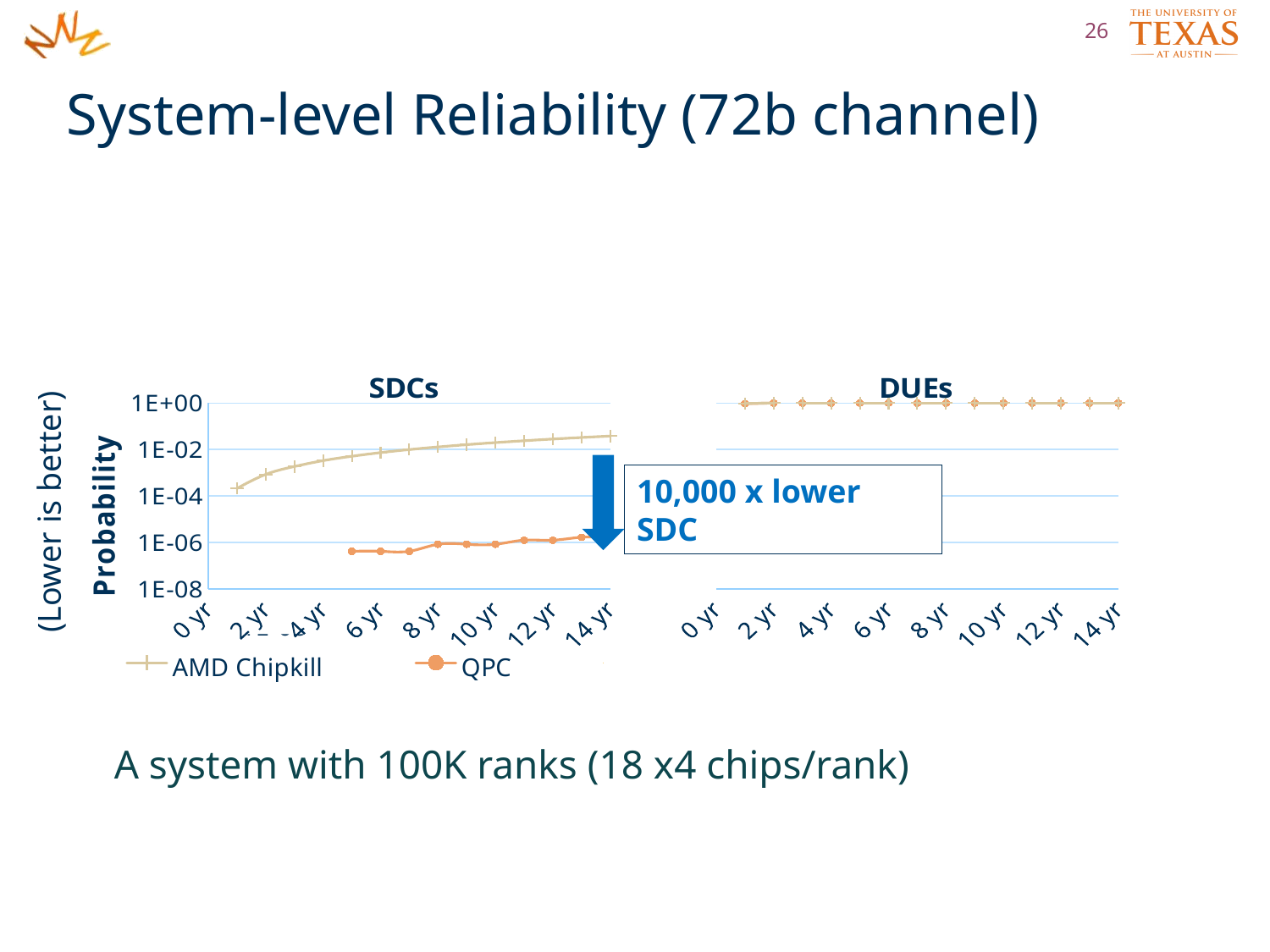
In the SDCs chart, which series has the higher probability at 14 yr, AMD Chipkill or QPC? AMD Chipkill In the SDCs chart, is the QPC value at 14 yr greater or less than 1E-04? less What are the two series named in the legend? AMD Chipkill and QPC In the DUEs chart, is the value at 10 yr greater or less than 1E-02? greater In the SDCs chart, which series has the lowest probability at 6 yr? QPC In the SDCs chart, is the AMD Chipkill value at 2 yr greater or less than 1E-04? greater What kind of chart is the SDCs chart? line chart In the SDCs chart, does the AMD Chipkill probability rise or fall as the years increase? rise How many series does the legend list? 2 How many year labels are shown on the x axis of the SDCs chart? 8 What is the title of the chart on the right? DUEs